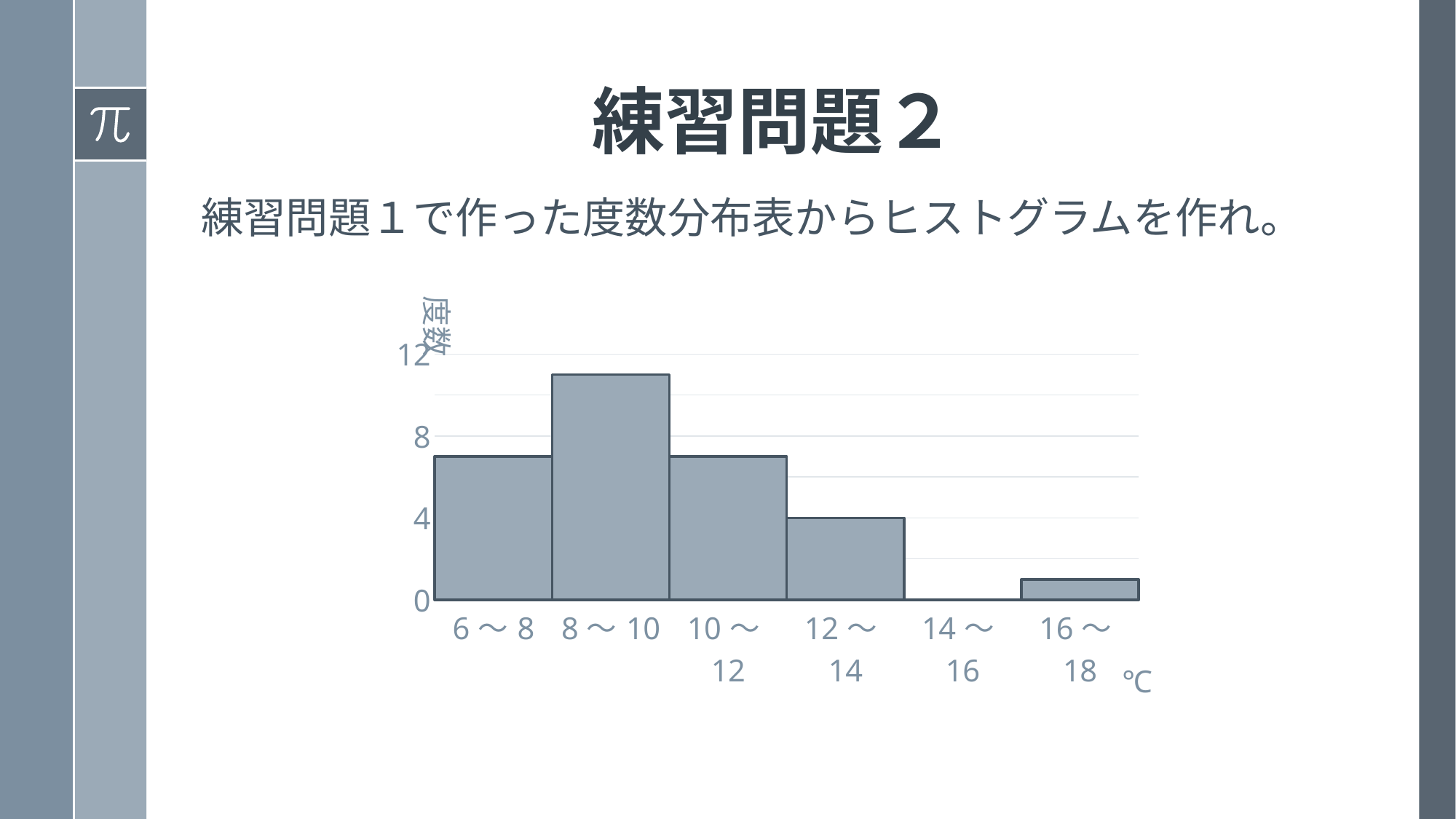
What is the frequency for the 14～16 class? 0 How many categories (class intervals) are shown on the x axis? 6 What kind of chart is shown on the slide? bar chart What is the frequency for the 12～14 class? 4 Which class interval has the highest frequency? 8～10 Which has the larger frequency, the 8～10 class or the 12～14 class? 8～10 What is the label on the vertical axis of the chart? 度数 Is the frequency for the 16～18 class greater or less than 4? less From the 8～10 class to the 14～16 class, do the frequencies rise or fall? fall Which class interval has the lowest frequency? 14～16 Is the frequency for the 8～10 class greater or less than 8? greater Is the frequency for the 6～8 class greater or less than 8? less